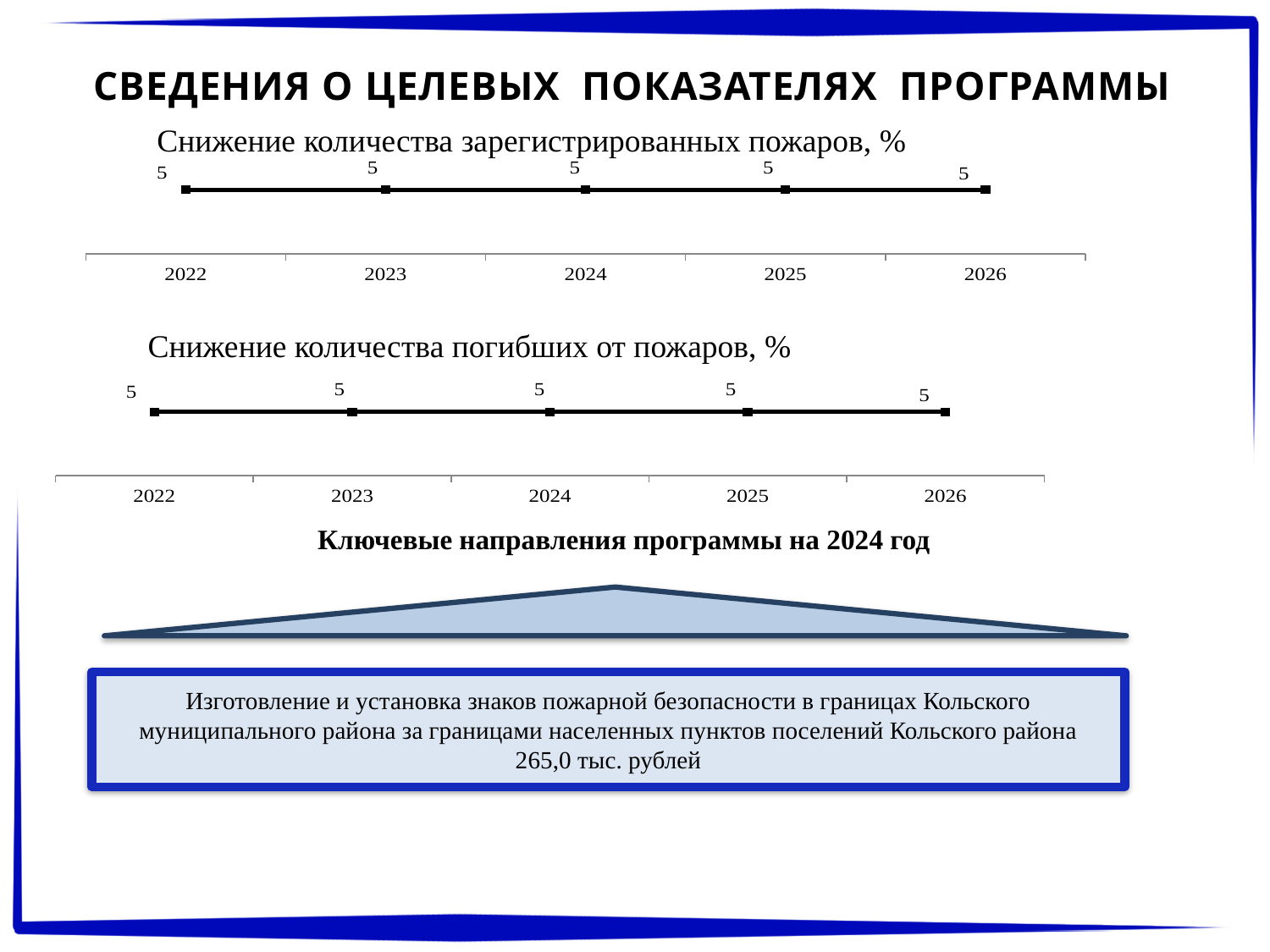
What kind of chart is the top chart, "Снижение количества зарегистрированных пожаров, %"? line chart In the chart titled "Снижение количества погибших от пожаров, %", what is the difference between the values for 2025 and 2022? 0 In the chart titled "Снижение количества погибших от пожаров, %", what is the value for 2026? 5 In the chart titled "Снижение количества зарегистрированных пожаров, %", do the values rise, fall or stay flat from 2022 to 2026? stay flat What is the first year shown on the x axis of the chart titled "Снижение количества зарегистрированных пожаров, %"? 2022 In the chart titled "Снижение количества погибших от пожаров, %", do the values rise, fall or stay flat from 2022 to 2026? stay flat In the chart titled "Снижение количества погибших от пожаров, %", what is the value for 2023? 5 What kind of chart is the bottom chart, "Снижение количества погибших от пожаров, %"? line chart How many years are shown on the x axis of the chart titled "Снижение количества погибших от пожаров, %"? 5 How many data points are plotted in the chart titled "Снижение количества зарегистрированных пожаров, %"? 5 In the chart titled "Снижение количества зарегистрированных пожаров, %", what is the value for 2024? 5 In the chart titled "Снижение количества зарегистрированных пожаров, %", what is the value for 2022? 5